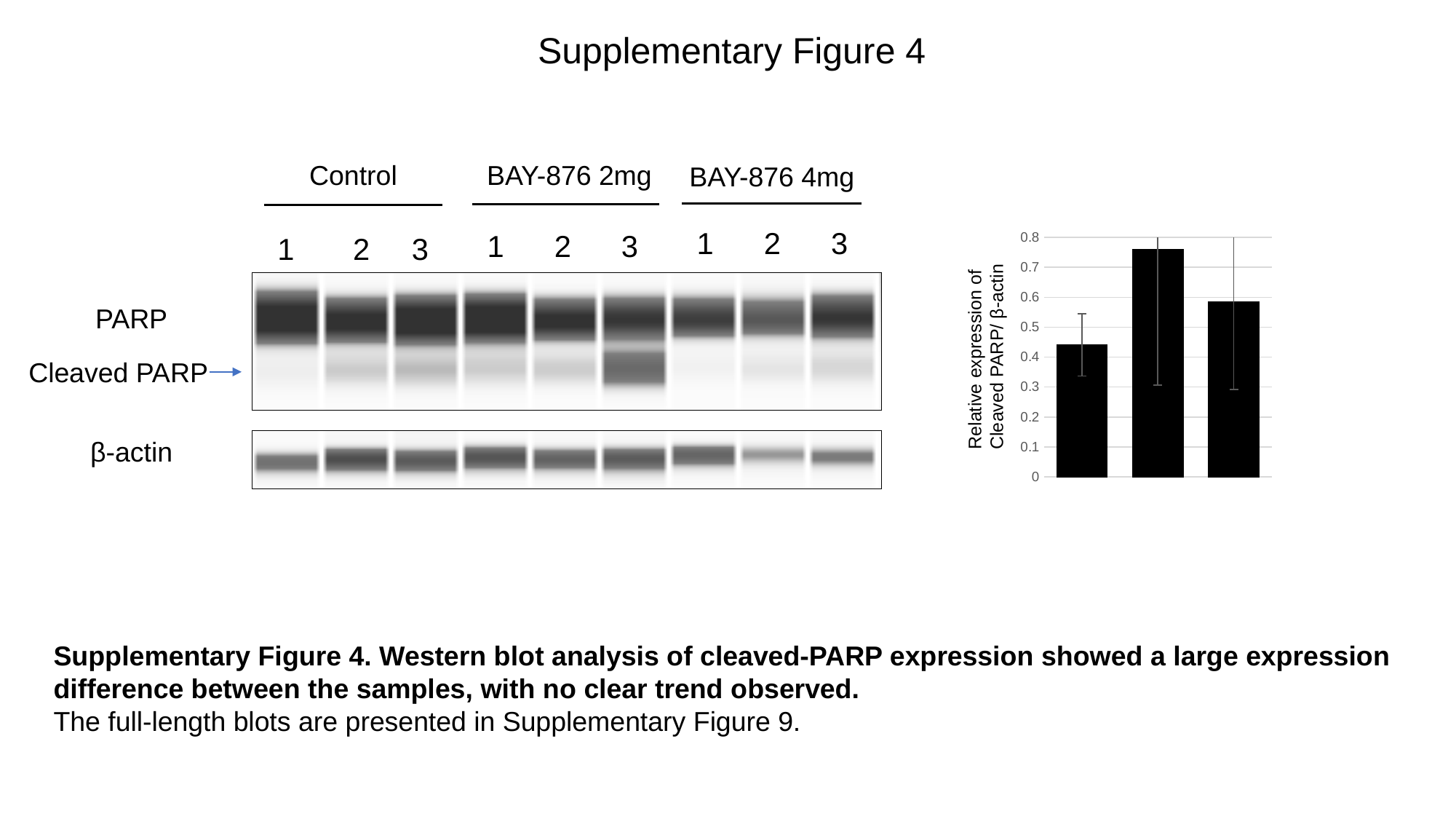
What kind of chart is shown on the right side of the slide? bar chart What is the highest tick value shown on the vertical axis of the bar chart? 0.8 In the bar chart, which is larger: the first bar or the third bar? third bar What is the label on the vertical axis of the bar chart? Relative expression of Cleaved PARP/ β-actin In the bar chart, which bar is the shortest: the first, second or third from the left? first In the bar chart, is the value of the third (rightmost) bar greater or less than 0.5? greater In the bar chart, is the value of the first (leftmost) bar greater or less than 0.5? less In the bar chart, is the value of the second (middle) bar greater or less than 0.7? greater In the bar chart, which bar is the tallest: the first, second or third from the left? second In the bar chart, which is larger: the second bar or the third bar? second bar How many bars does the chart on the right side of the slide contain? 3